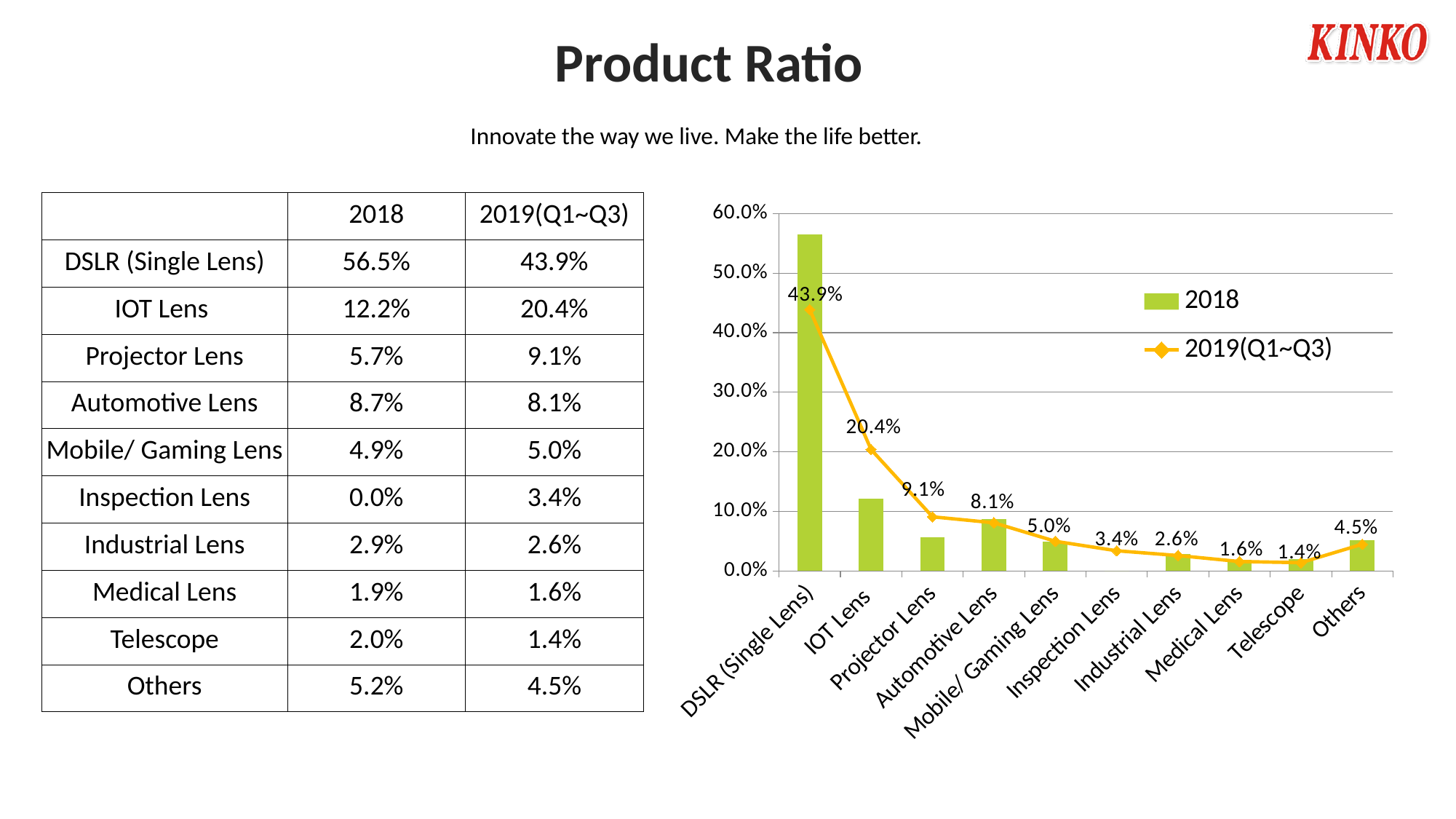
Is the 2018 bar for IOT Lens greater or less than 20.0%? less What is the 2019(Q1~Q3) value for IOT Lens in the chart? 20.4% Which category has the lowest 2019(Q1~Q3) value in the chart? Telescope How many categories are shown on the x axis of the chart? 10 What is the 2019(Q1~Q3) value for Projector Lens in the chart? 9.1% What is the 2019(Q1~Q3) value for Telescope in the chart? 1.4% Which series in the chart is drawn as a line with markers? 2019(Q1~Q3) How many series does the chart legend list? 2 Which category has the highest 2019(Q1~Q3) value in the chart? DSLR (Single Lens) Which has the larger 2019(Q1~Q3) value, Automotive Lens or Mobile/ Gaming Lens? Automotive Lens What is the difference between the 2019(Q1~Q3) values for DSLR (Single Lens) and IOT Lens? 23.5% Is the 2018 bar for DSLR (Single Lens) greater or less than 50.0%? greater